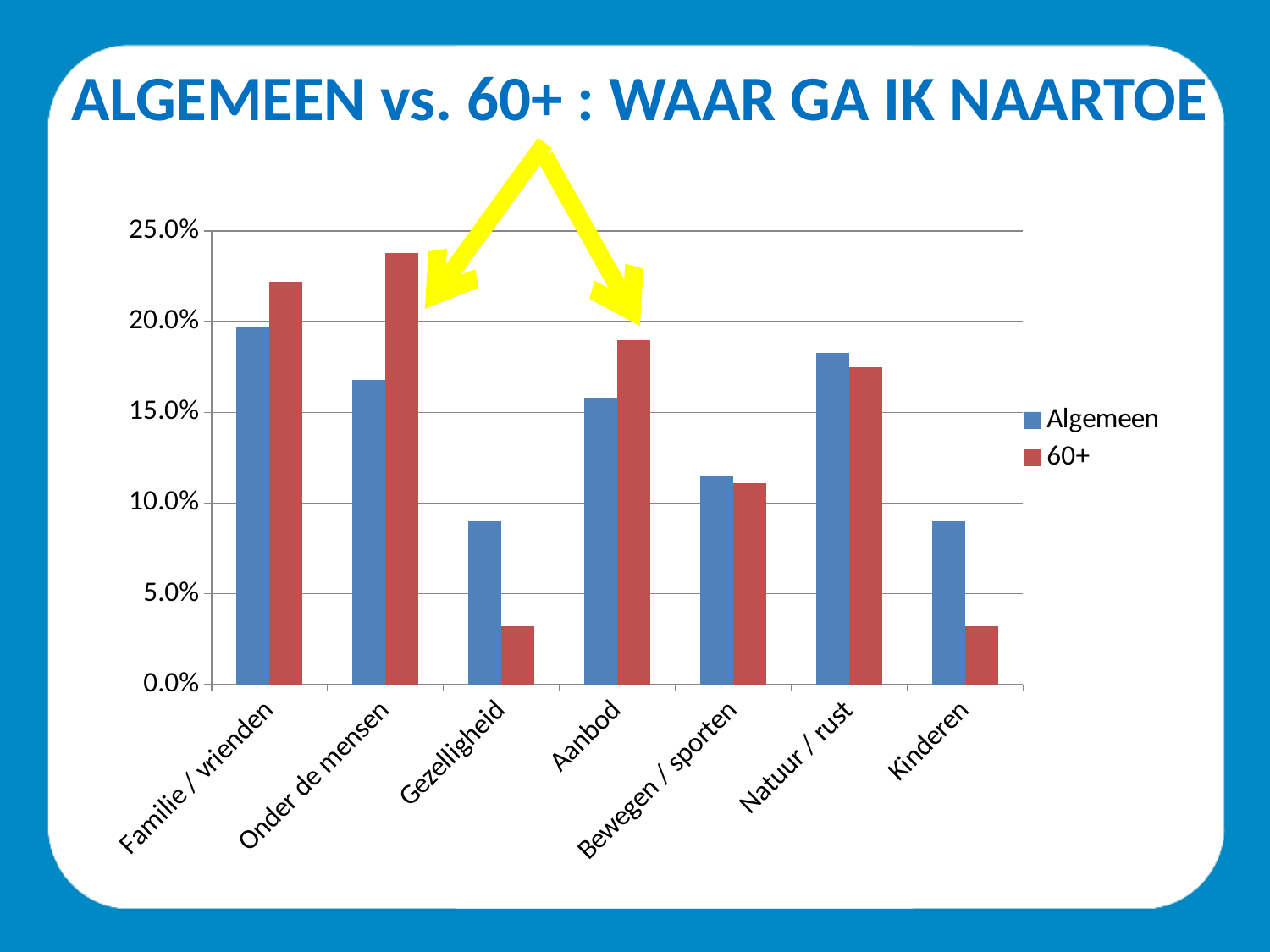
What kind of chart is shown on the slide? bar chart For Aanbod, which series has the larger value, Algemeen or 60+? 60+ Is the 60+ value for Onder de mensen greater or less than 20.0%? greater For Gezelligheid, which series has the larger value, Algemeen or 60+? Algemeen What is the title of the slide? ALGEMEEN vs. 60+ : WAAR GA IK NAARTOE How many categories are shown on the x axis? 7 For Onder de mensen, which series has the larger value, Algemeen or 60+? 60+ Is the Algemeen value for Gezelligheid greater or less than 10.0%? less Is the Algemeen value for Aanbod greater or less than 15.0%? greater Which category has the highest value for the 60+ series? Onder de mensen How many series does the legend list? 2